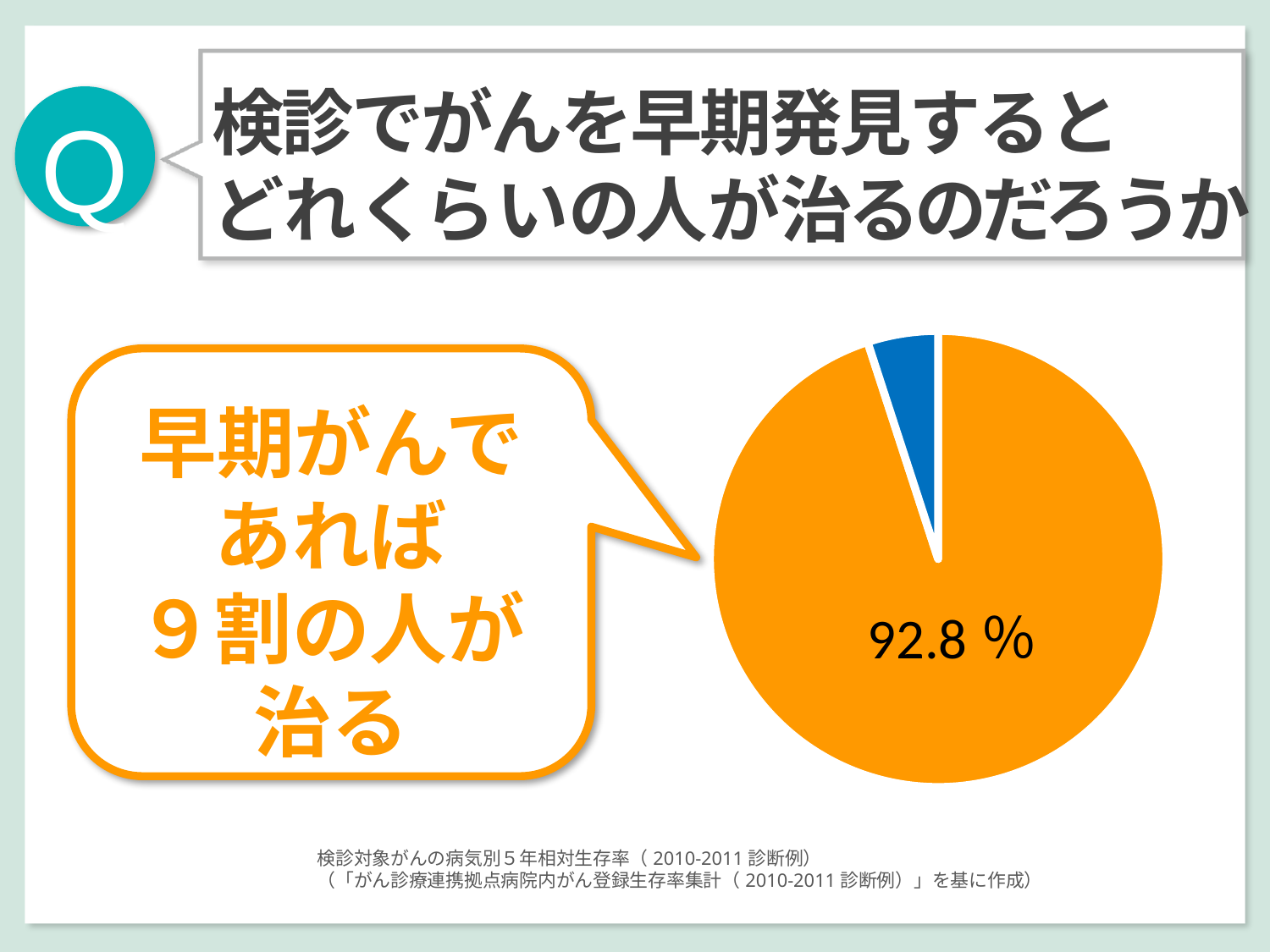
Which slice of the pie chart is the smallest? the blue slice What kind of chart is shown on the slide? pie chart Which slice of the pie chart is larger, the orange one or the blue one? the orange one Which slice of the pie chart is the largest? the orange slice Does the pie chart have a legend? No What value is printed on the orange slice of the pie chart? 92.8 % What colour is the slice labelled 92.8 % in the pie chart? orange How many slices does the pie chart have? 2